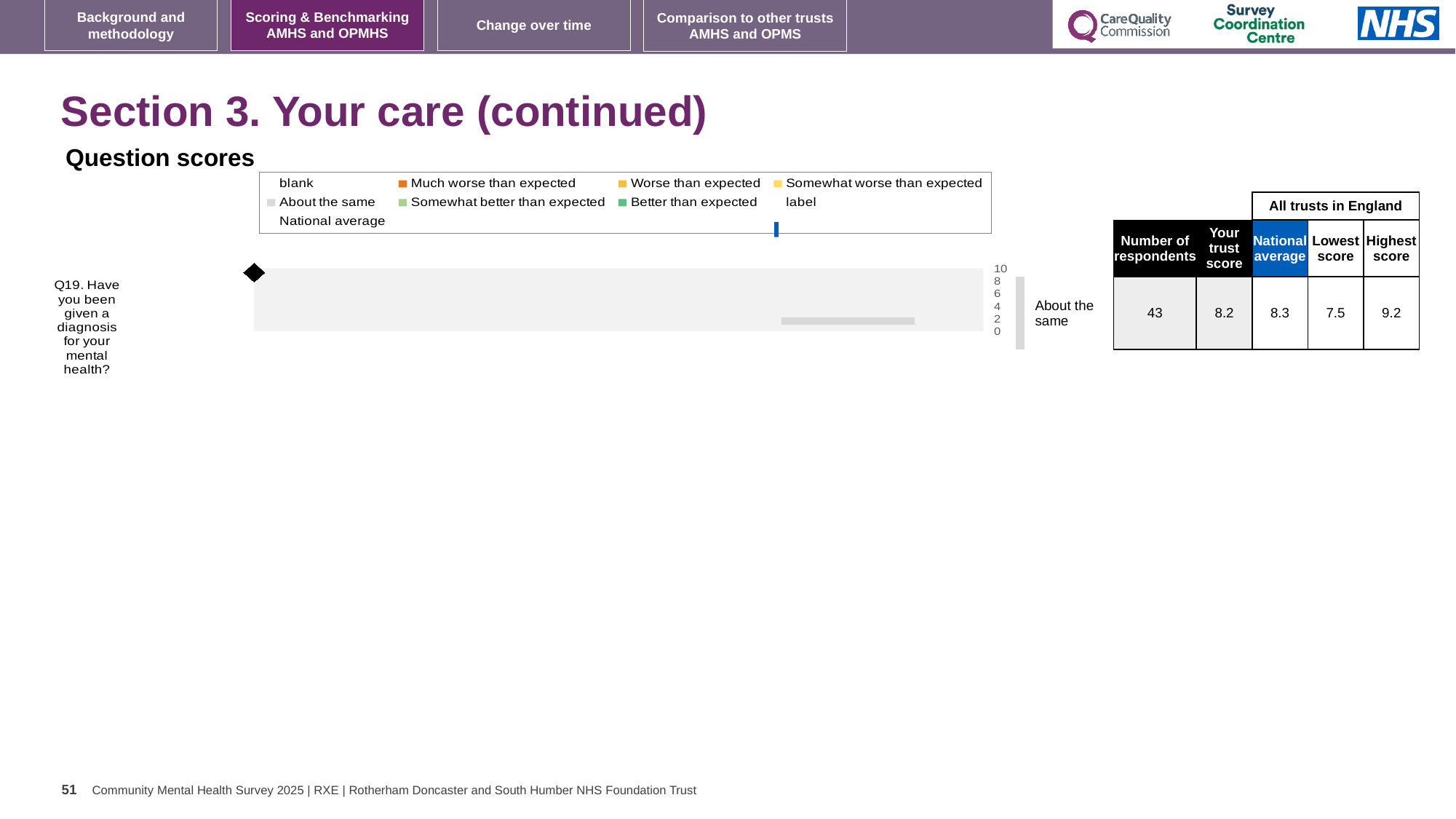
What is the difference between the highest and lowest scores for Q19 across all trusts in England? 1.7 How many survey questions are plotted on the chart? 1 What is the national average score for Q19? 8.3 Which legend entry is shown with an orange marker? Much worse than expected Which is larger for Q19: the trust's score or the national average? national average What is the trust's score for Q19 (Have you been given a diagnosis for your mental health?)? 8.2 What is the highest score among all trusts in England for Q19? 9.2 How many respondents answered Q19? 43 What benchmark category is shown next to the Q19 bar? About the same What is the difference between the national average and the trust's score for Q19? 0.1 What kind of chart is used to show the Q19 question score? bar chart What is the lowest score among all trusts in England for Q19? 7.5